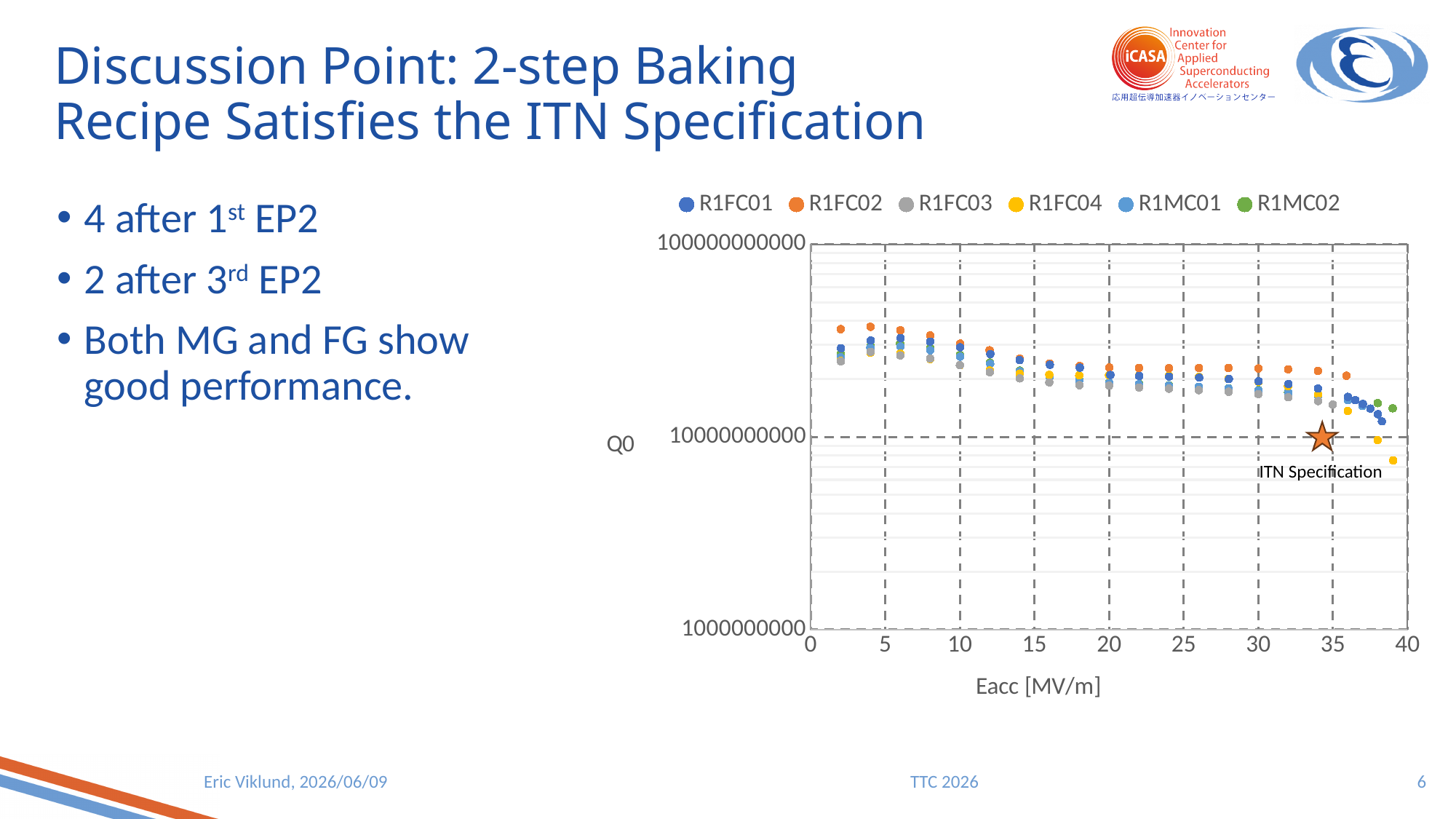
Is the Q0 value for R1FC04 at 39 MV/m greater or less than 10000000000? less Is the Q0 value for R1FC02 at 2 MV/m greater or less than 10000000000? greater Which series has the lowest Q0 values at the highest Eacc (around 38 to 39 MV/m)? R1FC04 What is the label of the y axis of the chart? Q0 What kind of chart is shown on the slide? scatter chart At 30 MV/m, which series has the larger Q0 value, R1FC02 or R1FC03? R1FC02 What is the maximum value shown on the x axis of the chart? 40 Do the Q0 values generally rise or fall as Eacc increases along the x axis? fall What is the label of the x axis of the chart? Eacc [MV/m] Is the Q0 value for R1FC03 at 20 MV/m greater or less than 100000000000? less Which series has the highest Q0 values at low Eacc (around 2 to 10 MV/m)? R1FC02 How many series does the chart legend list? 6